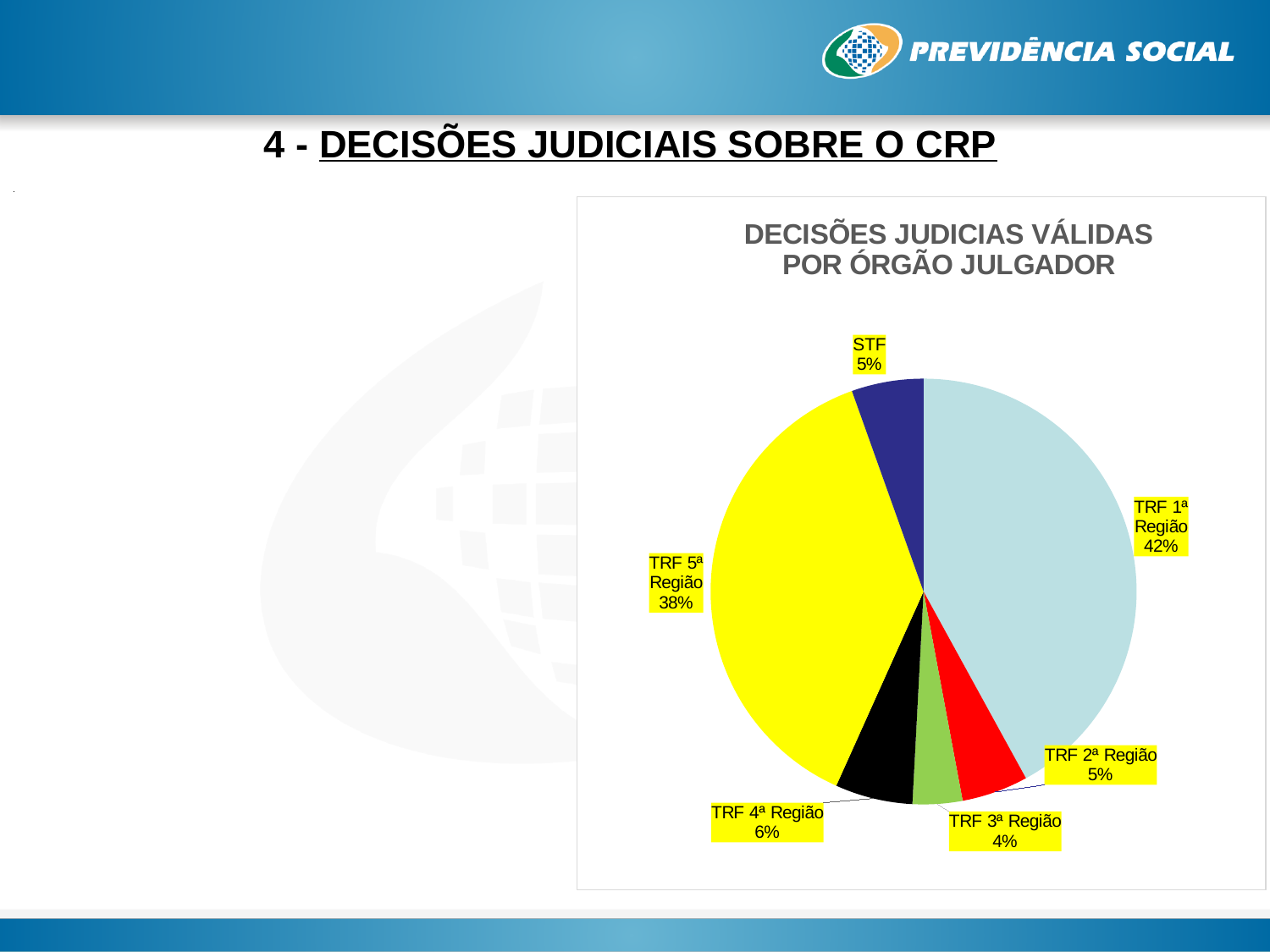
What share of the pie does TRF 1ª Região hold? 42% What is the value shown for STF? 5% What is the difference between the shares of TRF 1ª Região and TRF 5ª Região? 4% What is the value shown for TRF 4ª Região? 6% What is the value shown for TRF 3ª Região? 4% Which category has the largest slice of the pie? TRF 1ª Região What kind of chart is shown on the slide? pie chart What share of the pie does TRF 5ª Região hold? 38% Which is larger, the share for TRF 4ª Região or the share for TRF 2ª Região? TRF 4ª Região What is the title of the chart? DECISÕES JUDICIAS VÁLIDAS POR ÓRGÃO JULGADOR How many categories are shown in the pie chart? 6 Which category has the smallest slice of the pie? TRF 3ª Região